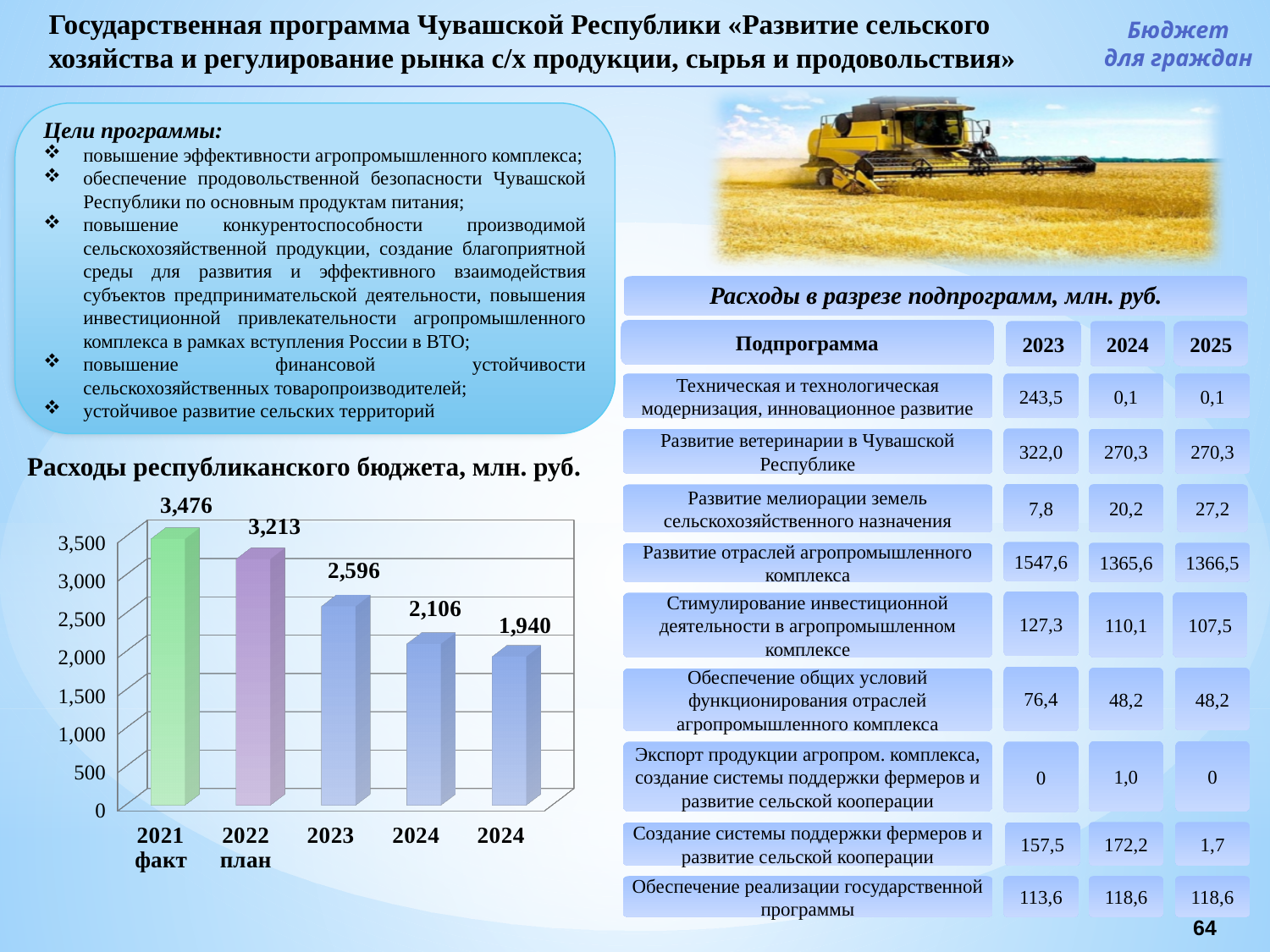
What is the lowest value shown in the chart 'Расходы республиканского бюджета, млн. руб.'? 1,940 What is the difference between the values for 2022 план and 2023 in the chart 'Расходы республиканского бюджета, млн. руб.'? 617 Do the values in the chart 'Расходы республиканского бюджета, млн. руб.' rise or fall from left to right? fall What is the difference between the values for 2021 факт and 2022 план in the chart 'Расходы республиканского бюджета, млн. руб.'? 263 What type of chart is 'Расходы республиканского бюджета, млн. руб.'? bar chart How many bars are shown in the chart 'Расходы республиканского бюджета, млн. руб.'? 5 What is the value for 2021 факт in the chart 'Расходы республиканского бюджета, млн. руб.'? 3,476 Which category has the highest value in the chart 'Расходы республиканского бюджета, млн. руб.'? 2021 факт Which is larger in the chart 'Расходы республиканского бюджета, млн. руб.': the value for 2022 план or the value for 2023? 2022 план What is the value of the last (rightmost) bar in the chart 'Расходы республиканского бюджета, млн. руб.'? 1,940 What is the value for 2023 in the chart 'Расходы республиканского бюджета, млн. руб.'? 2,596 What is the value for 2022 план in the chart 'Расходы республиканского бюджета, млн. руб.'? 3,213